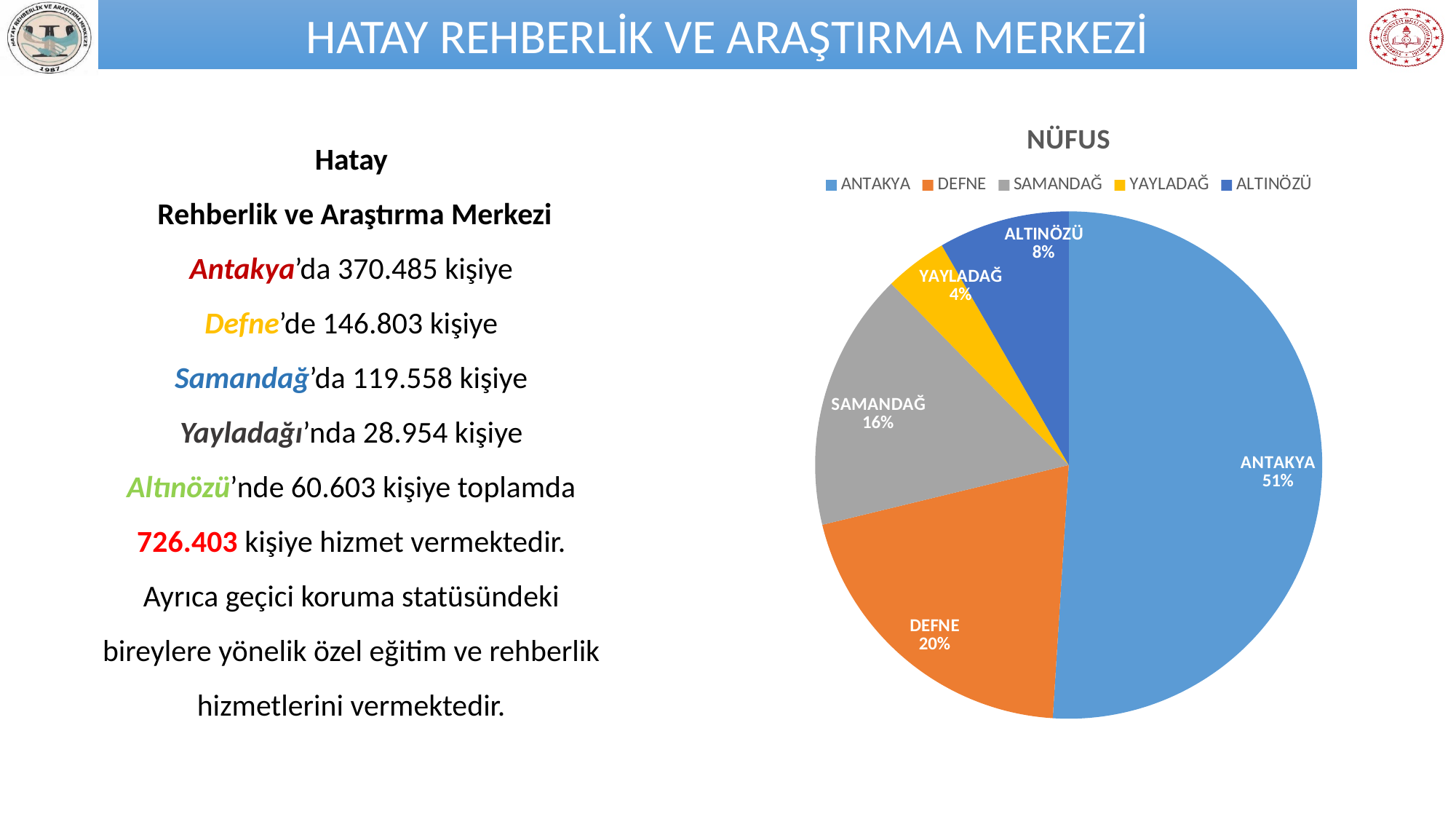
Which district has the smallest slice of the pie chart? YAYLADAĞ What percentage share does YAYLADAĞ have in the pie chart? 4% What percentage share does ANTAKYA have in the pie chart? 51% What type of chart is shown on the slide? pie chart Which slice is larger, ALTINÖZÜ or YAYLADAĞ? ALTINÖZÜ What percentage share does DEFNE have in the pie chart? 20% Which district has the largest slice of the pie chart? ANTAKYA What is the title of the chart? NÜFUS What is the difference in percentage points between the DEFNE and SAMANDAĞ slices? 4 What percentage share does SAMANDAĞ have in the pie chart? 16% How many slices does the pie chart have? 5 What percentage share does ALTINÖZÜ have in the pie chart? 8%